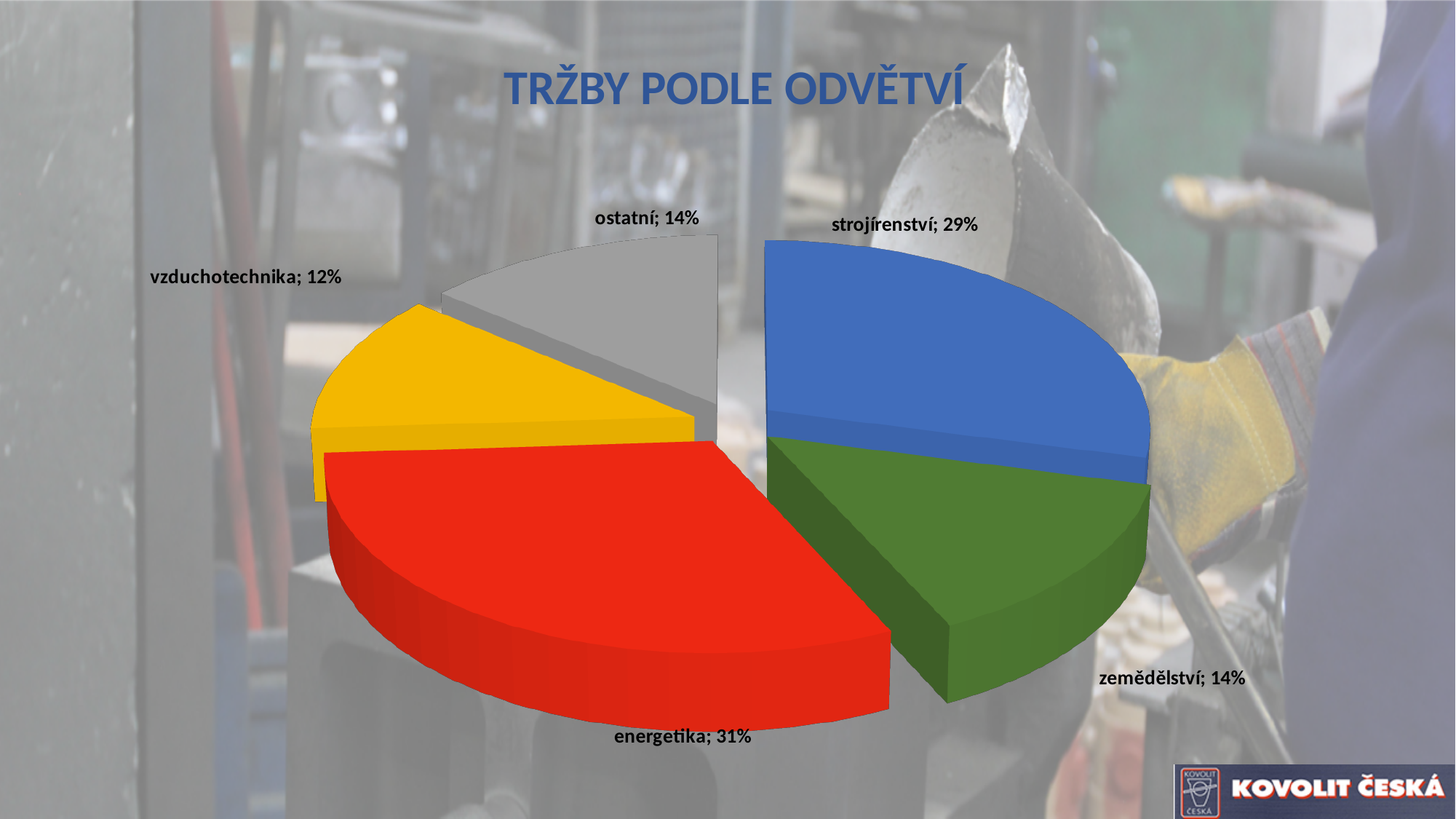
What share of revenue does vzduchotechnika account for? 12% Which has a larger share, strojírenství or zemědělství? strojírenství What is the difference in percentage points between ostatní and vzduchotechnika? 2 What share of revenue does energetika account for? 31% Which sector has the largest share of revenue? energetika What type of chart is shown on the slide? pie chart How many sectors are shown in the pie chart? 5 What is the title of the chart? TRŽBY PODLE ODVĚTVÍ What share of revenue does strojírenství account for? 29% What is the difference in percentage points between energetika and strojírenství? 2 What share of revenue does zemědělství account for? 14% Which sector has the smallest share of revenue? vzduchotechnika